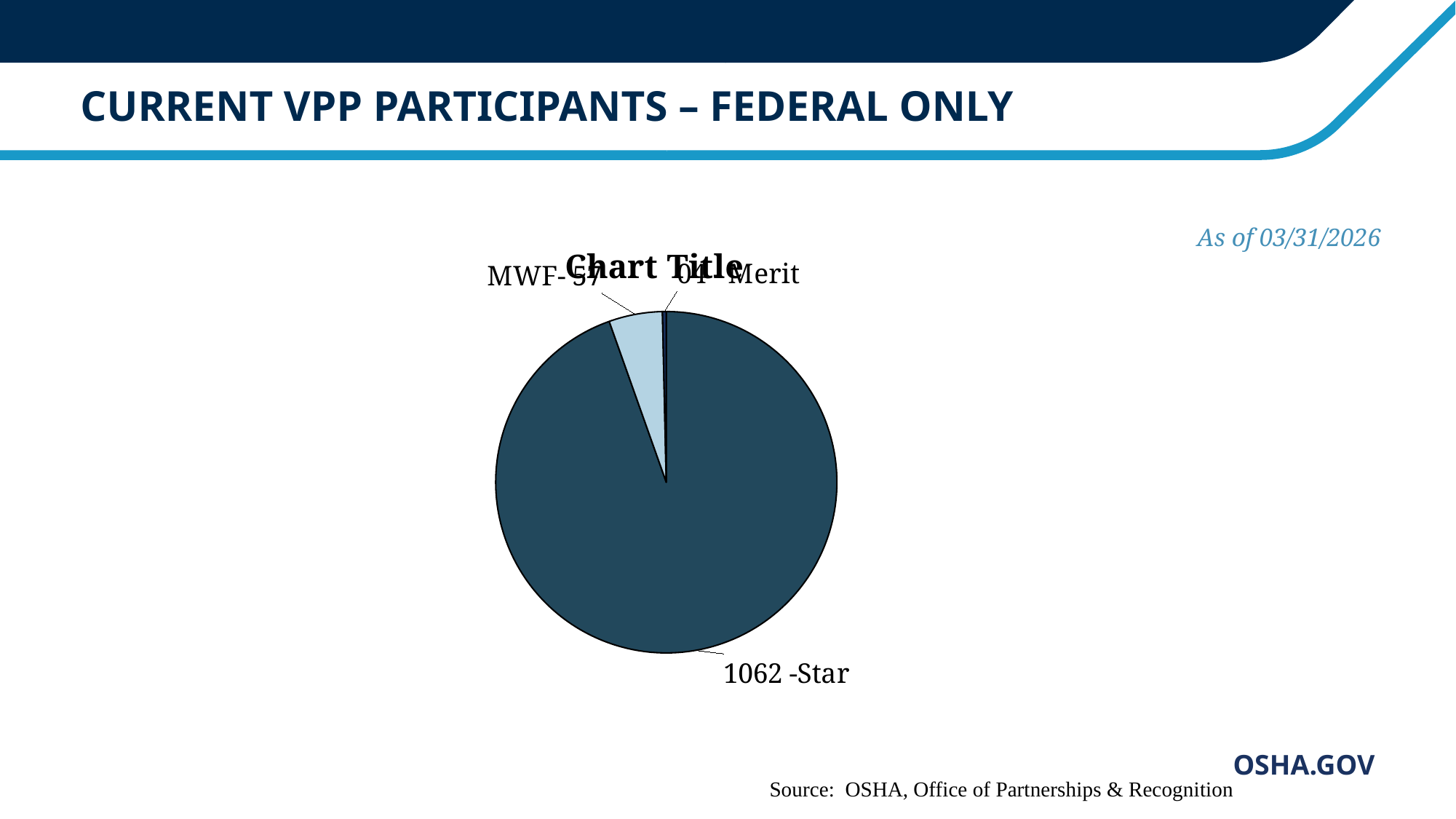
What type of chart is shown on the slide? pie chart How many slices does the pie chart have? 3 What title is printed above the pie chart? Chart Title What 'as of' date is shown on the slide for the chart data? 03/31/2026 Which category has the smallest slice of the pie? Merit Which category has the largest slice of the pie? Star Which slice is larger, Star or MWF? Star Which slice is larger, MWF or Merit? MWF What is the value shown for the Star slice? 1062